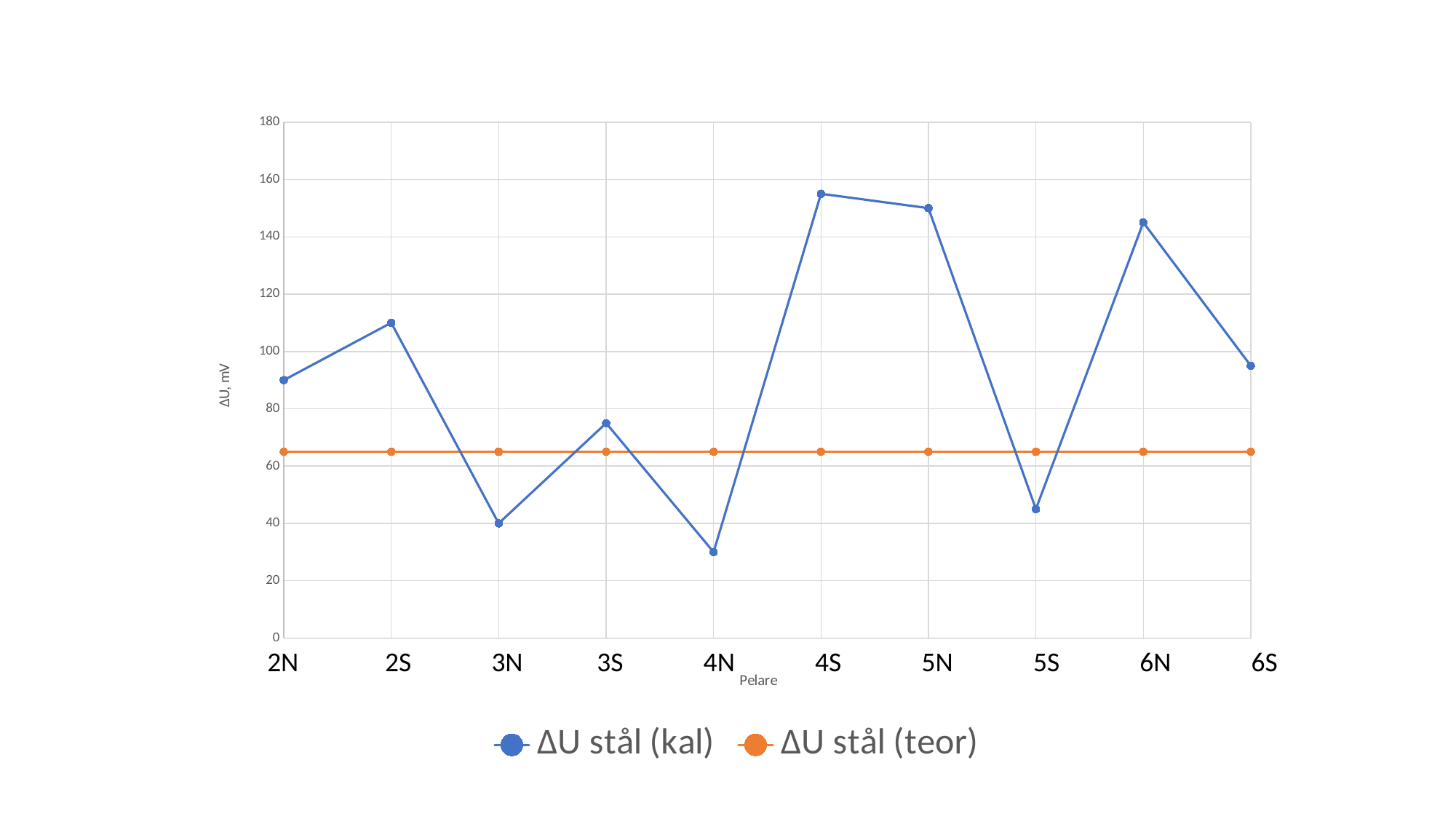
Which is larger for ΔU stål (kal): the value for 6N or the value for 6S? 6N Is the value of ΔU stål (kal) for 4S greater or less than 140? greater What kind of chart is shown on the slide? line chart How many categories are shown on the x axis? 10 Is the value of ΔU stål (kal) for 2S greater or less than 100? greater Does the ΔU stål (teor) series rise, fall or stay flat across the x axis? stay flat Is the value of ΔU stål (kal) for 5S greater or less than 60? less What is the value of ΔU stål (kal) for 3N? 40 At 4N, which series has the larger value: ΔU stål (kal) or ΔU stål (teor)? ΔU stål (teor) Which category has the lowest value for ΔU stål (kal)? 4N What is the title of the x axis? Pelare How many series does the legend list? 2